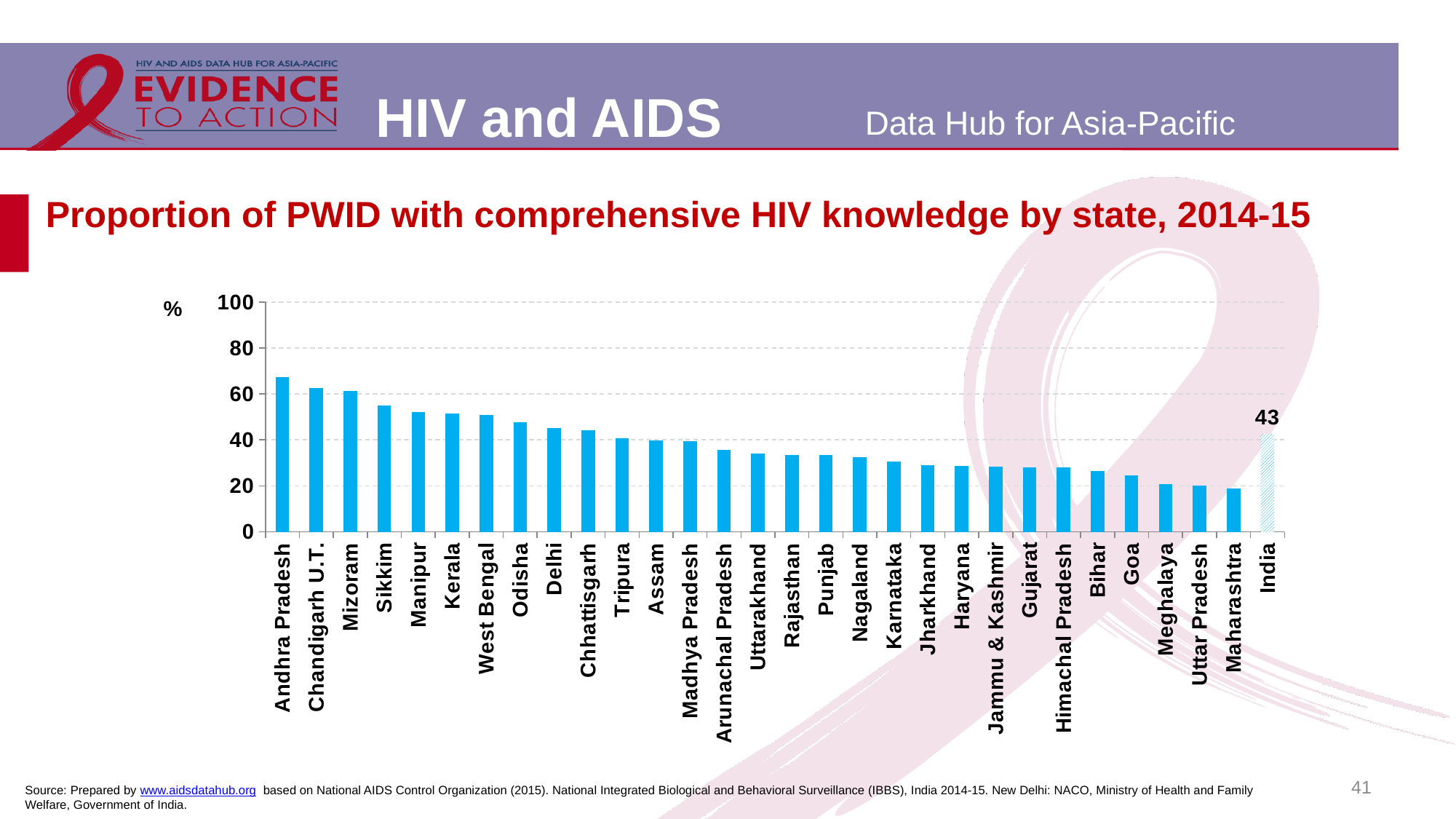
Which has a higher value, Sikkim or Goa? Sikkim What type of chart is shown on the slide? bar chart Do the state values rise or fall from left to right across the x axis (excluding the India bar)? fall What is the value shown for India? 43 Is the value for Andhra Pradesh greater or less than 60? greater Which has a higher value, Bihar or Delhi? Delhi Is the value for Bihar greater or less than 40? less Which state has the lowest proportion of PWID with comprehensive HIV knowledge? Maharashtra Which state has the highest proportion of PWID with comprehensive HIV knowledge? Andhra Pradesh Is the value for Kerala greater or less than 40? greater How many categories (states/UTs plus India) are shown on the x axis? 30